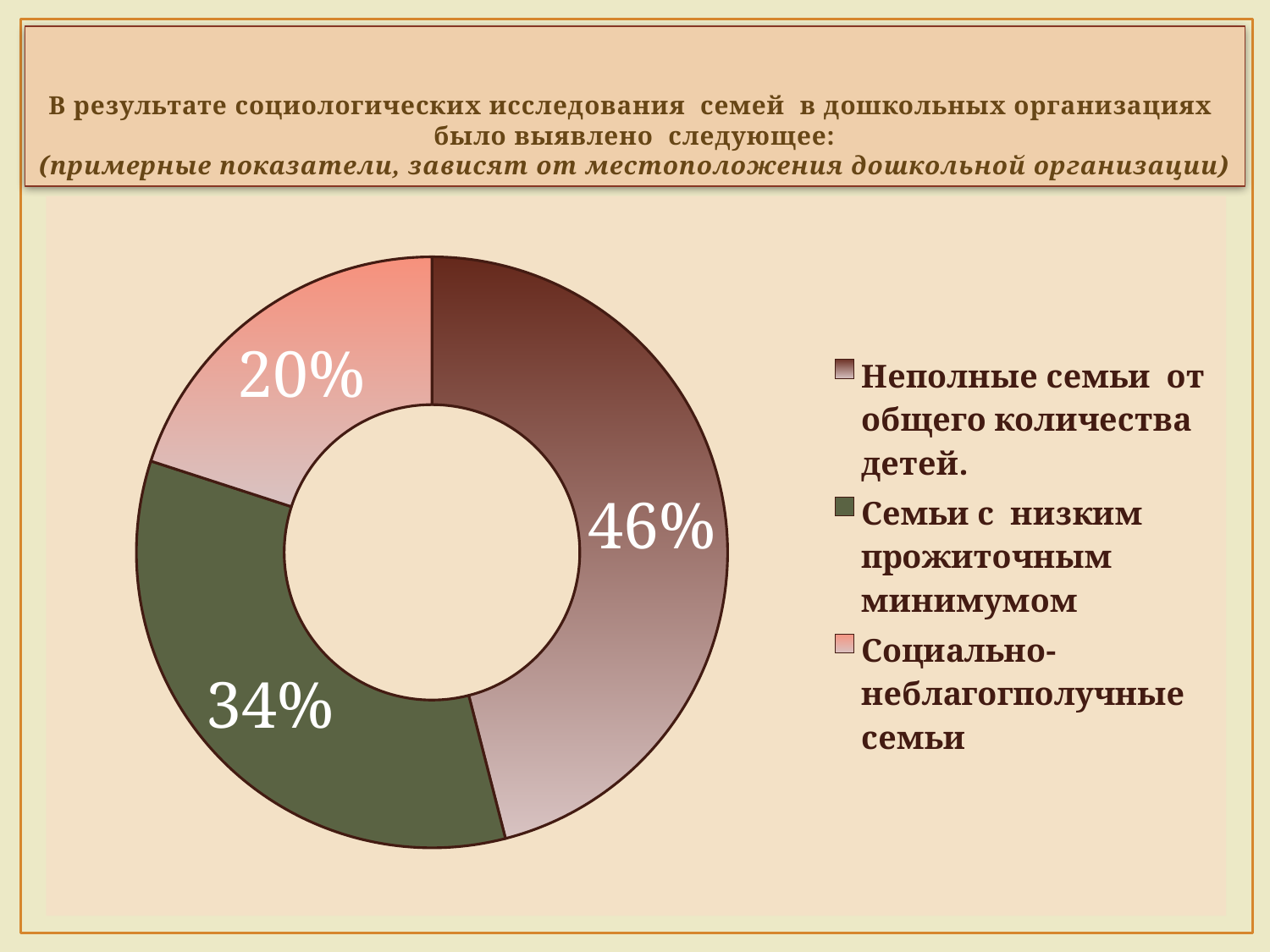
What is the difference in percentage points between 'Семьи с низким прожиточным минимумом' and 'Социально-неблагогполучные семьи'? 14 What is the difference in percentage points between 'Неполные семьи' and 'Семьи с низким прожиточным минимумом'? 12 How many categories does the chart show? 3 Which is larger: the share for 'Семьи с низким прожиточным минимумом' or the share for 'Социально-неблагогполучные семьи'? Семьи с низким прожиточным минимумом What percentage is shown for 'Социально-неблагогполучные семьи'? 20% What percentage is shown for 'Неполные семьи от общего количества детей'? 46% Which category has the largest share of the chart? Неполные семьи от общего количества детей What colour is the slice for 'Семьи с низким прожиточным минимумом'? Green Which category has the smallest share of the chart? Социально-неблагогполучные семьи What kind of chart is shown on the slide? Doughnut (pie) chart Is the share for 'Неполные семьи от общего количества детей' greater or less than 50%? less What percentage is shown for 'Семьи с низким прожиточным минимумом'? 34%